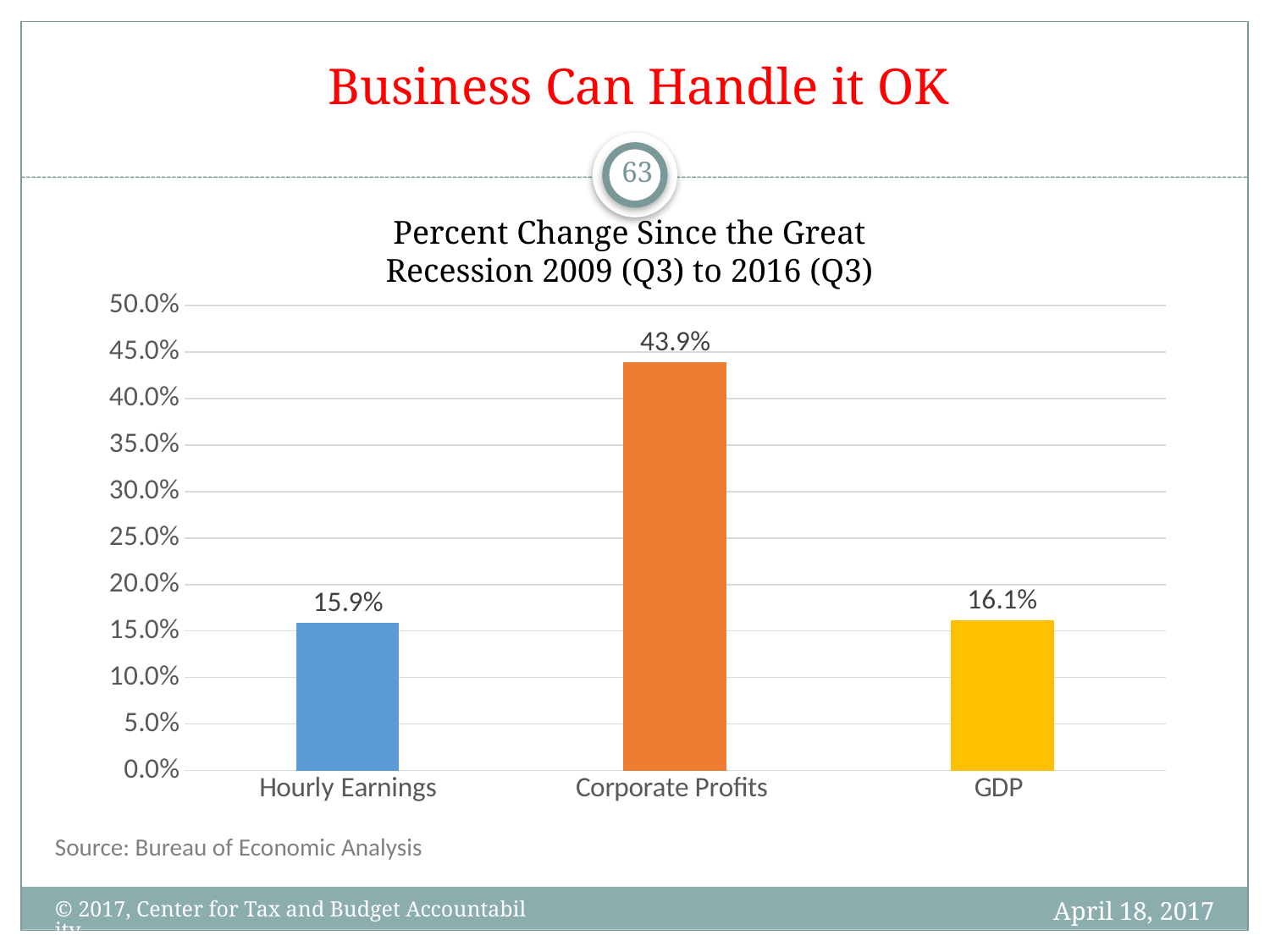
How many categories are shown in the chart? 3 Is the value for Corporate Profits greater or less than 40.0%? greater Which category has the highest percent change? Corporate Profits What is the difference between the percent change for GDP and Hourly Earnings? 0.2% What kind of chart is shown on the slide? Bar chart What is the percent change for GDP? 16.1% Which category has the lowest percent change? Hourly Earnings What is the percent change for Hourly Earnings? 15.9% Which is larger, the percent change for Corporate Profits or for Hourly Earnings? Corporate Profits What is the percent change for Corporate Profits? 43.9% What is the difference between the percent change for Corporate Profits and GDP? 27.8% What is the title of the chart? Percent Change Since the Great Recession 2009 (Q3) to 2016 (Q3)